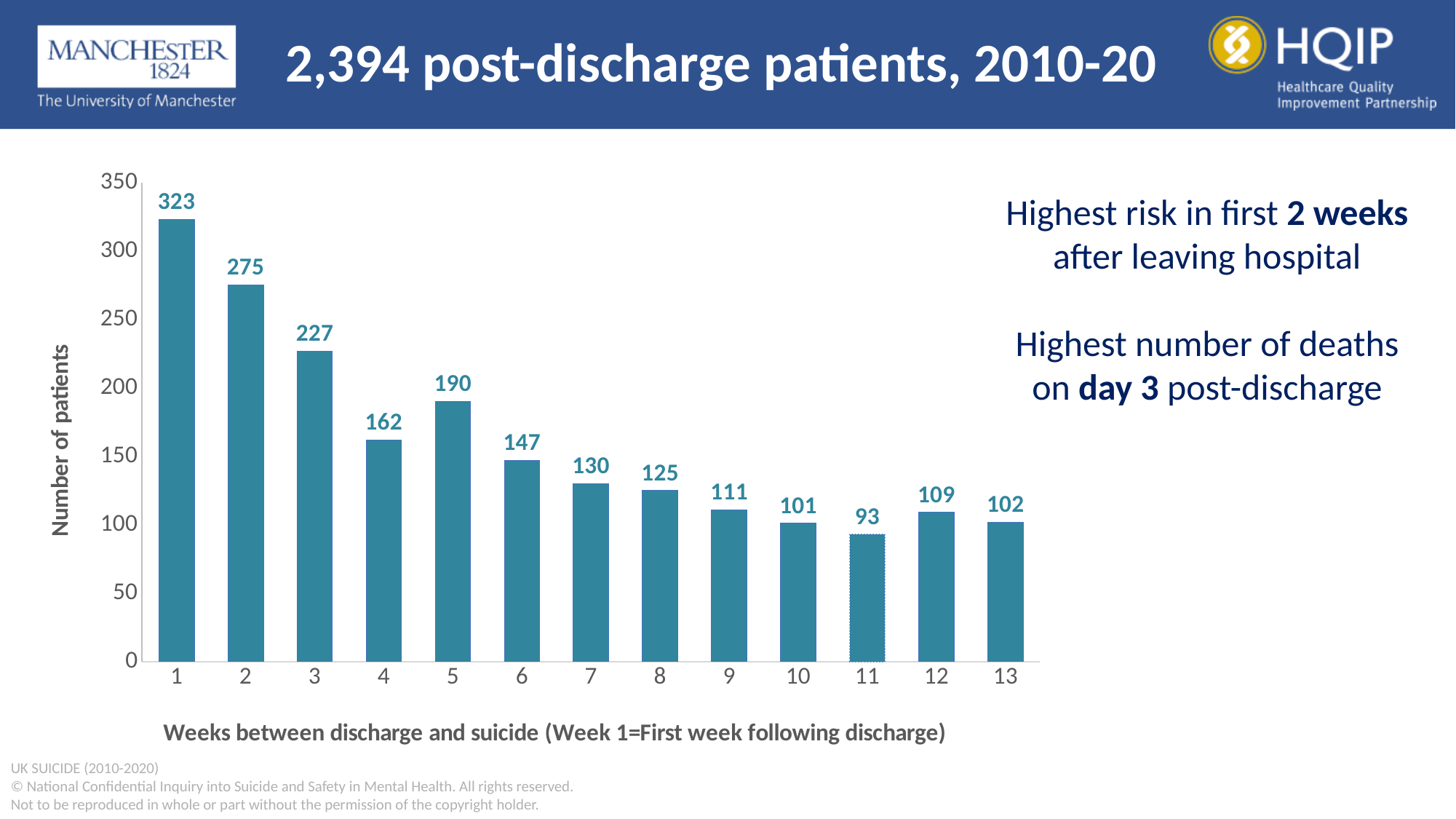
What is the difference in number of patients between week 4 and week 5? 28 What is the number of patients for week 1? 323 What is the difference in number of patients between week 1 and week 2? 48 What is the number of patients for week 11? 93 How many weeks are shown on the x axis? 13 Which week has the lowest number of patients? 11 What is the label of the y axis? Number of patients Which has more patients, week 12 or week 13? Week 12 What is the number of patients for week 5? 190 Is the value for week 3 greater or less than 200? greater What kind of chart is shown on the slide? Bar chart Which week has the highest number of patients? 1